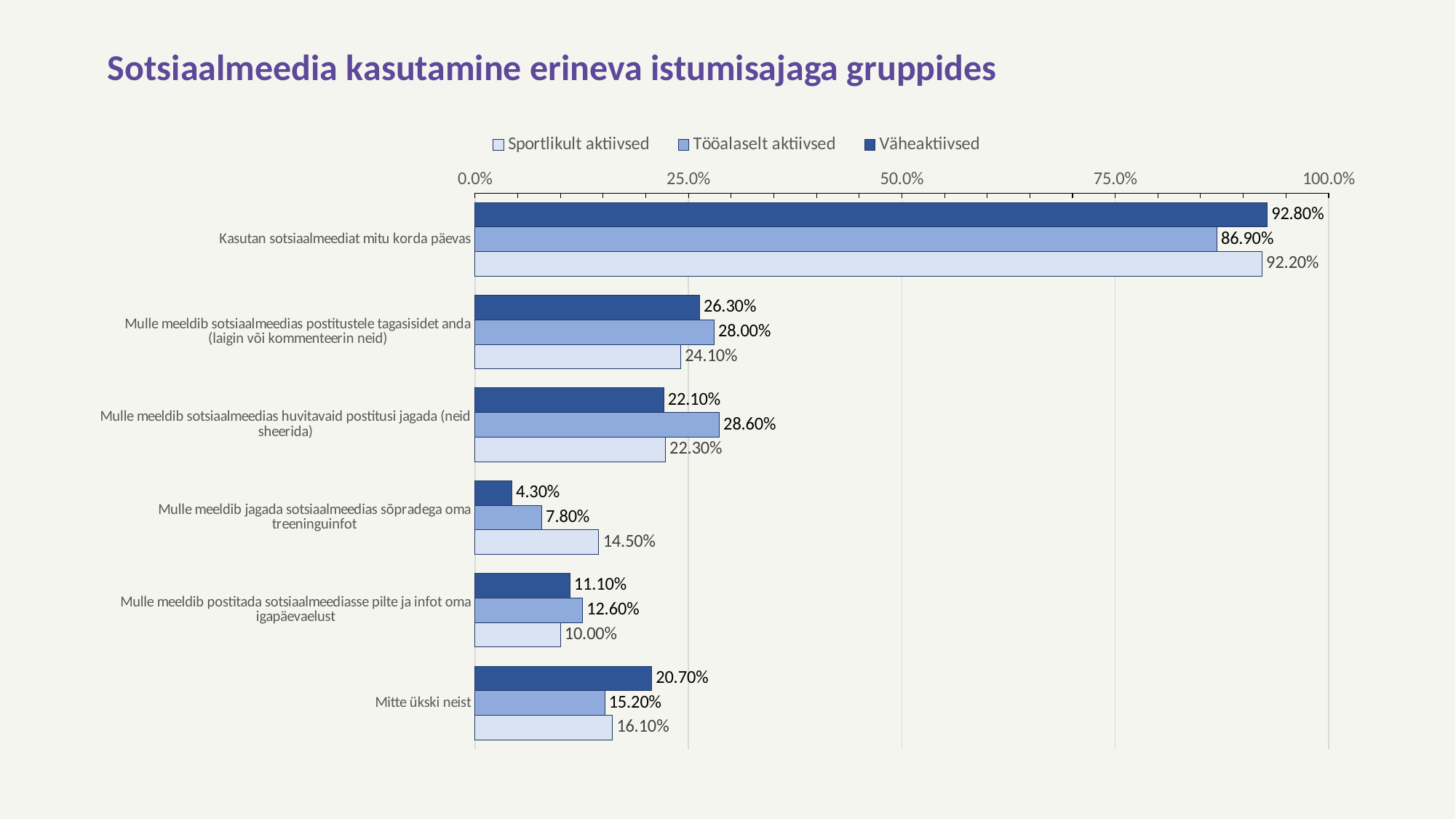
What is the title of the chart? Sotsiaalmeedia kasutamine erineva istumisajaga gruppides How many categories are shown on the chart? 6 Which series has the lowest value in the category 'Mulle meeldib jagada sotsiaalmeedias sõpradega oma treeninguinfot'? Väheaktiivsed Is the value for Tööalaselt aktiivsed in the category 'Mulle meeldib sotsiaalmeedias postitustele tagasisidet anda (laigin või kommenteerin neid)' greater or less than 25.0%? greater What is the value for Väheaktiivsed in the category 'Kasutan sotsiaalmeediat mitu korda päevas'? 92.80% How many series does the legend list? 3 What type of chart is shown on the slide? bar chart What is the value for Sportlikult aktiivsed in the category 'Mulle meeldib jagada sotsiaalmeedias sõpradega oma treeninguinfot'? 14.50% In the category 'Mitte ükski neist', which is larger: the value for Väheaktiivsed or for Sportlikult aktiivsed? Väheaktiivsed What is the difference between the Väheaktiivsed and Tööalaselt aktiivsed values in the category 'Kasutan sotsiaalmeediat mitu korda päevas'? 5.90% Which series has the highest value in the category 'Mulle meeldib sotsiaalmeedias huvitavaid postitusi jagada (neid sheerida)'? Tööalaselt aktiivsed What is the value for Tööalaselt aktiivsed in the category 'Mitte ükski neist'? 15.20%